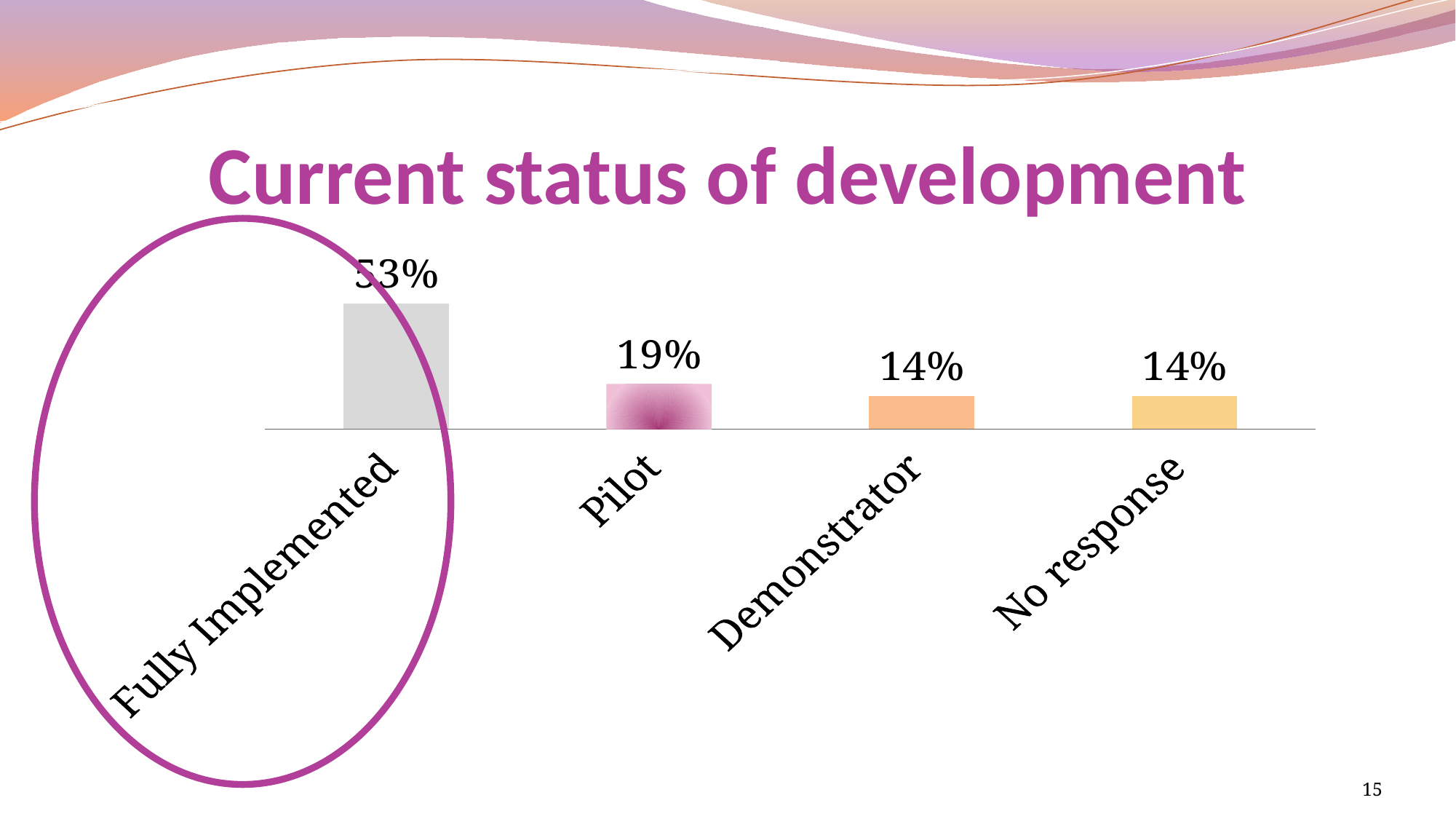
Which is larger, the value for Pilot or the value for No response? Pilot What is the difference between the values for Pilot and Demonstrator? 5% What is the value for Demonstrator? 14% How many categories are shown in the chart? 4 What is the value for Pilot? 19% What is the title of the slide? Current status of development Which category has the highest value? Fully Implemented What is the value for No response? 14% Which category is circled on the slide? Fully Implemented What kind of chart is shown on the slide? Bar chart What is the difference between the values for Fully Implemented and Pilot? 34% What is the value for Fully Implemented? 53%